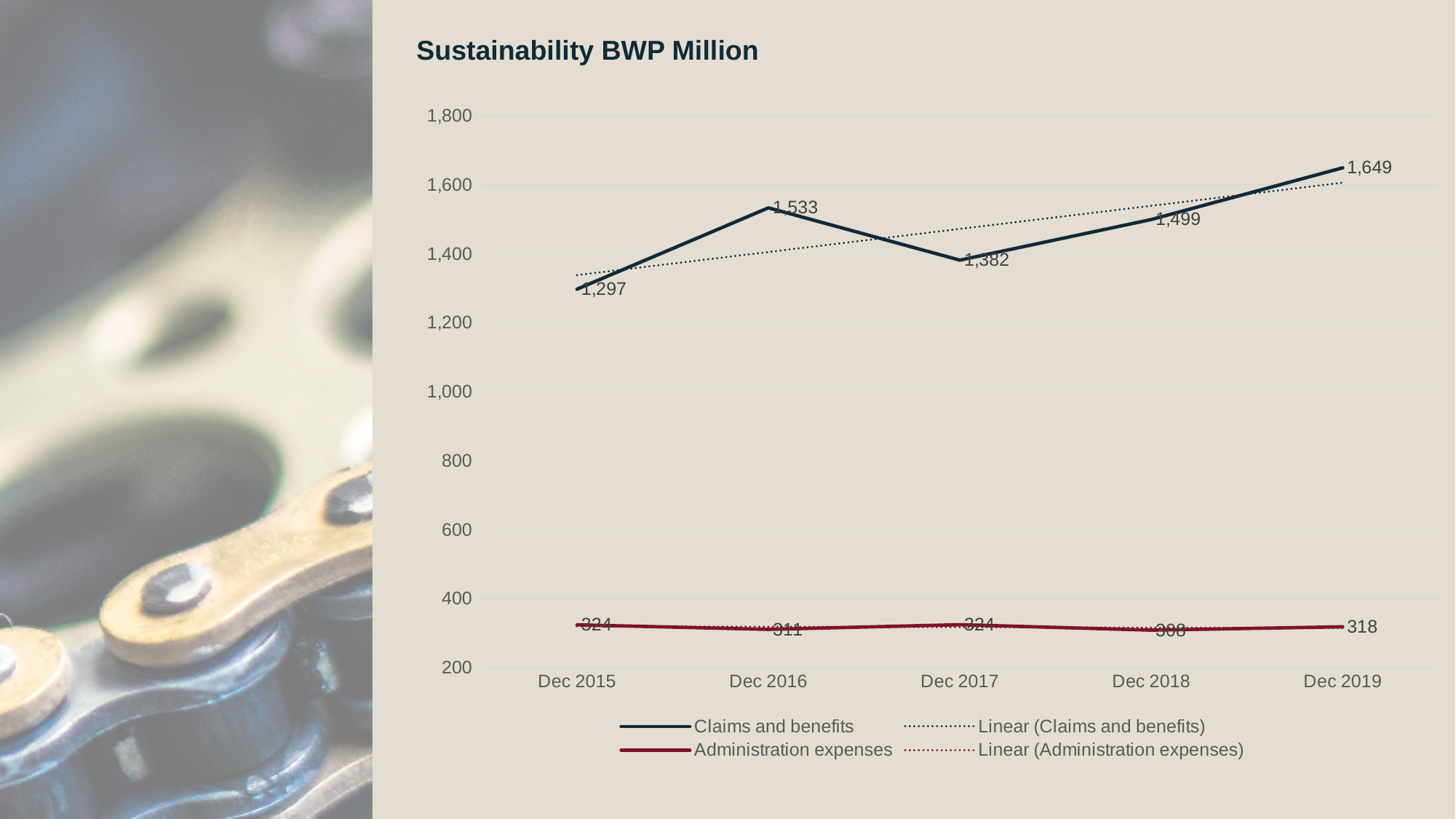
How many periods are shown on the x axis? 5 Is the value of Claims and benefits in Dec 2017 greater or less than 1,400? less What is the value of Claims and benefits in Dec 2019? 1,649 What is the value of Administration expenses in Dec 2018? 308 What type of chart is shown on the slide? Line chart What is the title of the chart? Sustainability BWP Million Which is larger: Administration expenses in Dec 2016 or in Dec 2017? Dec 2017 What is the difference between Claims and benefits in Dec 2019 and Dec 2015? 352 In which period is Claims and benefits at its lowest? Dec 2015 In which period is Claims and benefits at its highest? Dec 2019 What is the value of Claims and benefits in Dec 2016? 1,533 How many entries does the legend list? 4